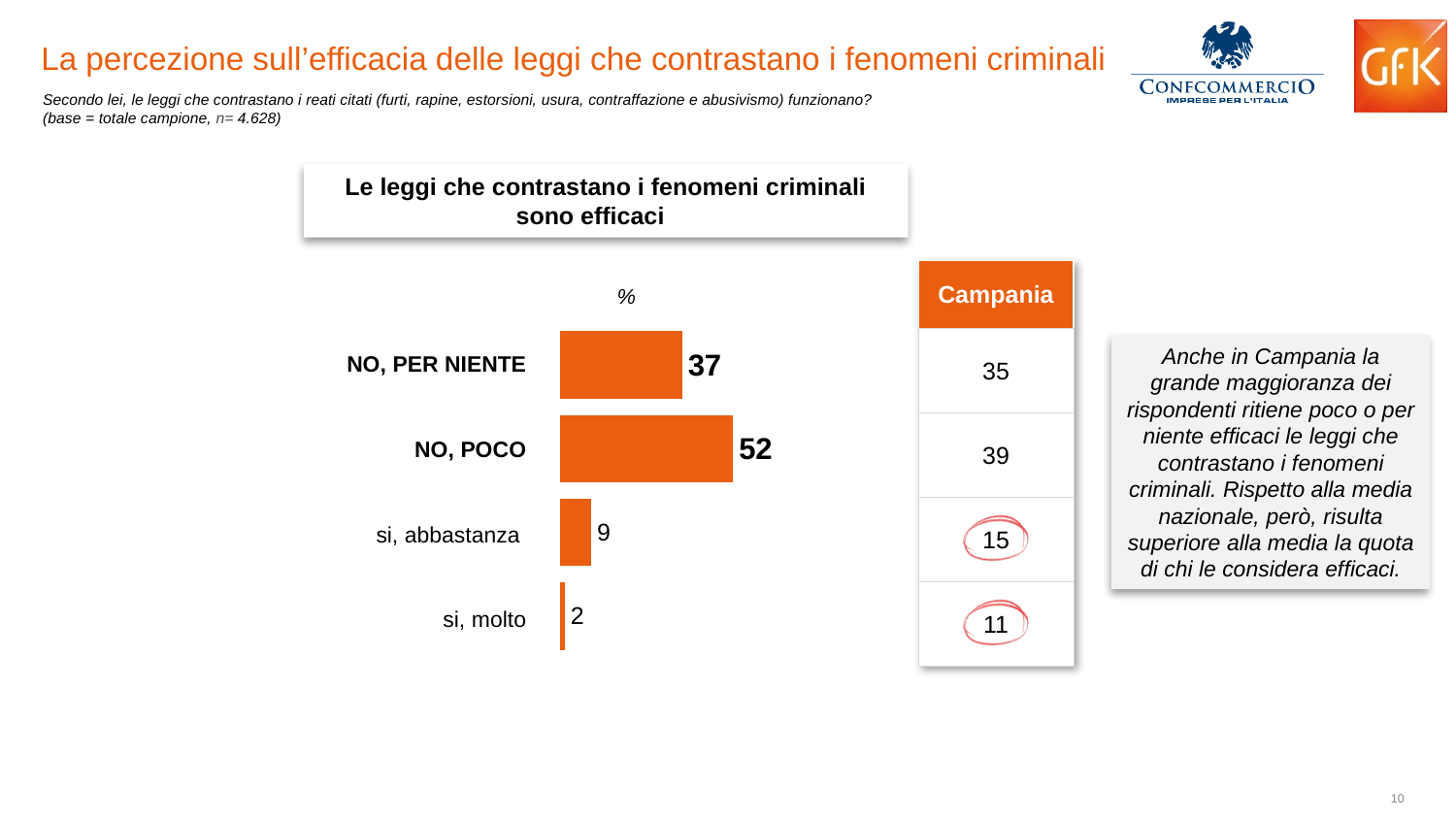
In the Campania column next to the chart, what is the value for "si, abbastanza"? 15 What is the value for "si, abbastanza" in the bar chart? 9 Which category has the lowest value in the bar chart? si, molto What is the value for "si, molto" in the bar chart? 2 How many categories are shown in the bar chart? 4 Which is larger in the bar chart: "si, abbastanza" or "si, molto"? si, abbastanza What is the value for "NO, POCO" in the bar chart? 52 What is the title of the chart? Le leggi che contrastano i fenomeni criminali sono efficaci What is the difference between the values for "NO, POCO" and "NO, PER NIENTE" in the bar chart? 15 What type of chart is shown on the slide? bar chart What is the value for "NO, PER NIENTE" in the bar chart? 37 Which category has the highest value in the bar chart? NO, POCO